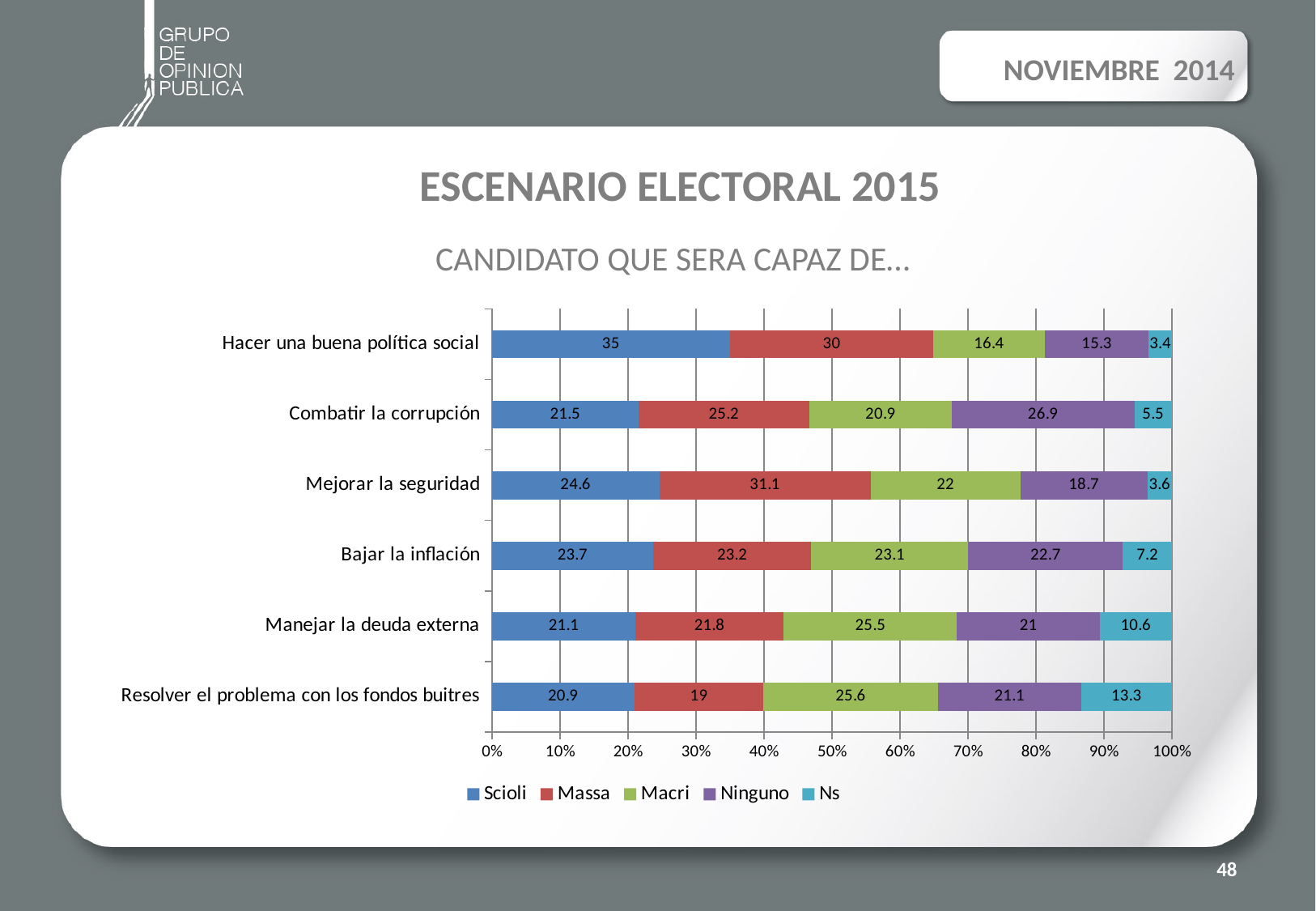
What is the difference between the Scioli and Massa values for "Hacer una buena política social"? 5 What is the value for Ninguno in the "Combatir la corrupción" bar? 26.9 What is the value for Ns in the "Resolver el problema con los fondos buitres" bar? 13.3 For which category is the Ns value lowest? Hacer una buena política social For "Combatir la corrupción", which is larger: the Massa value or the Macri value? Massa How many categories are shown on the chart? 6 For which category is the Scioli value highest? Hacer una buena política social What is the value for Massa in the "Mejorar la seguridad" bar? 31.1 What kind of chart is shown on the slide? Stacked bar chart How many series does the legend list? 5 Which series is shown in green in the legend? Macri What is the value for Scioli in the "Hacer una buena política social" bar? 35